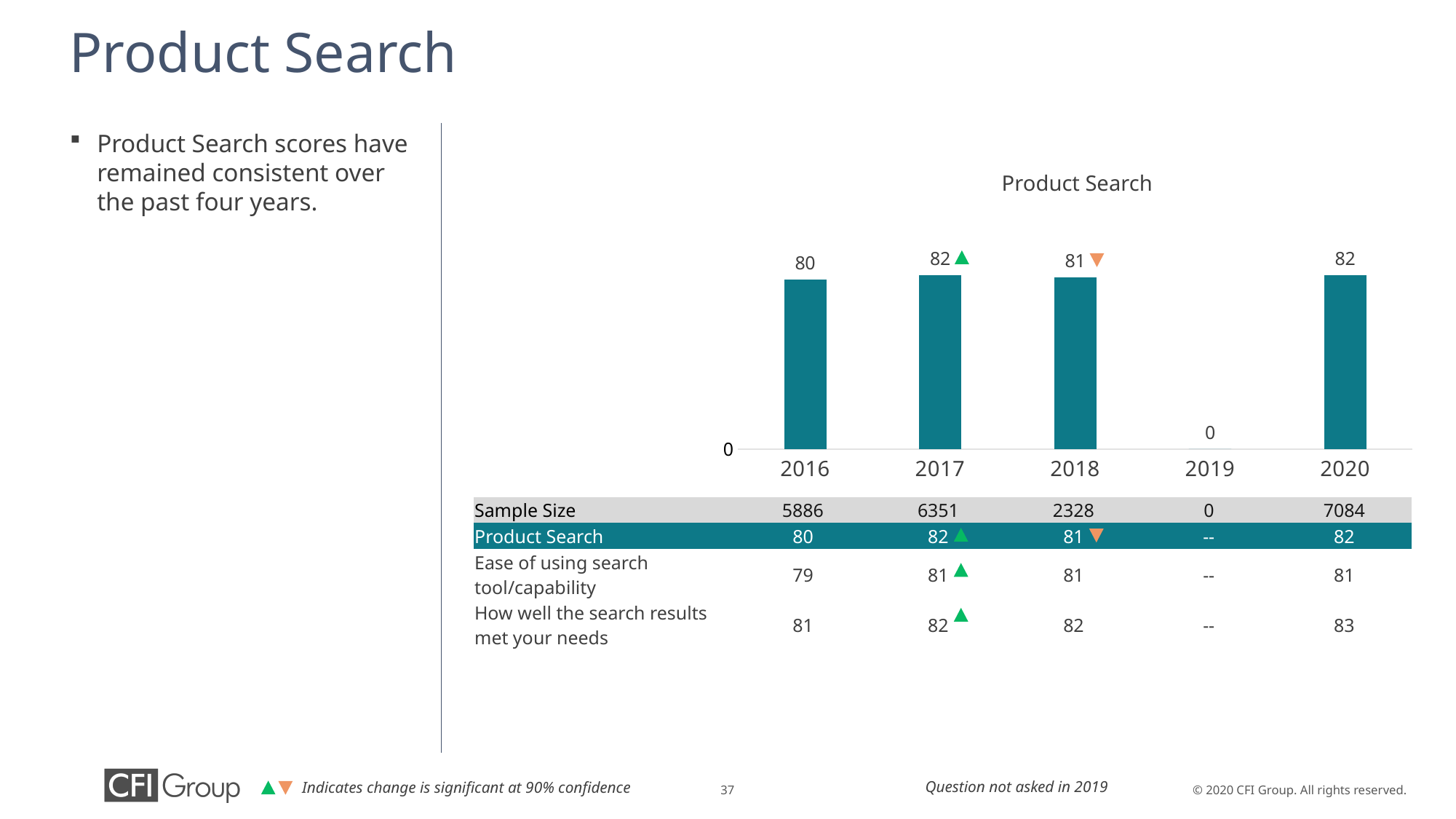
How many years are shown on the x axis of the chart? 5 Excluding 2019, which year has the lowest Product Search value? 2016 What type of chart is shown on the slide? bar chart What is the difference between the Product Search values for 2017 and 2016? 2 What is the Product Search value for 2020? 82 What value is shown for 2019 in the chart? 0 What is the Product Search value for 2016? 80 What is the Product Search value for 2018? 81 What is the title of the chart? Product Search Which year has the lowest value in the chart? 2019 What is the Product Search value for 2017? 82 Which year has the larger Product Search value, 2016 or 2018? 2018